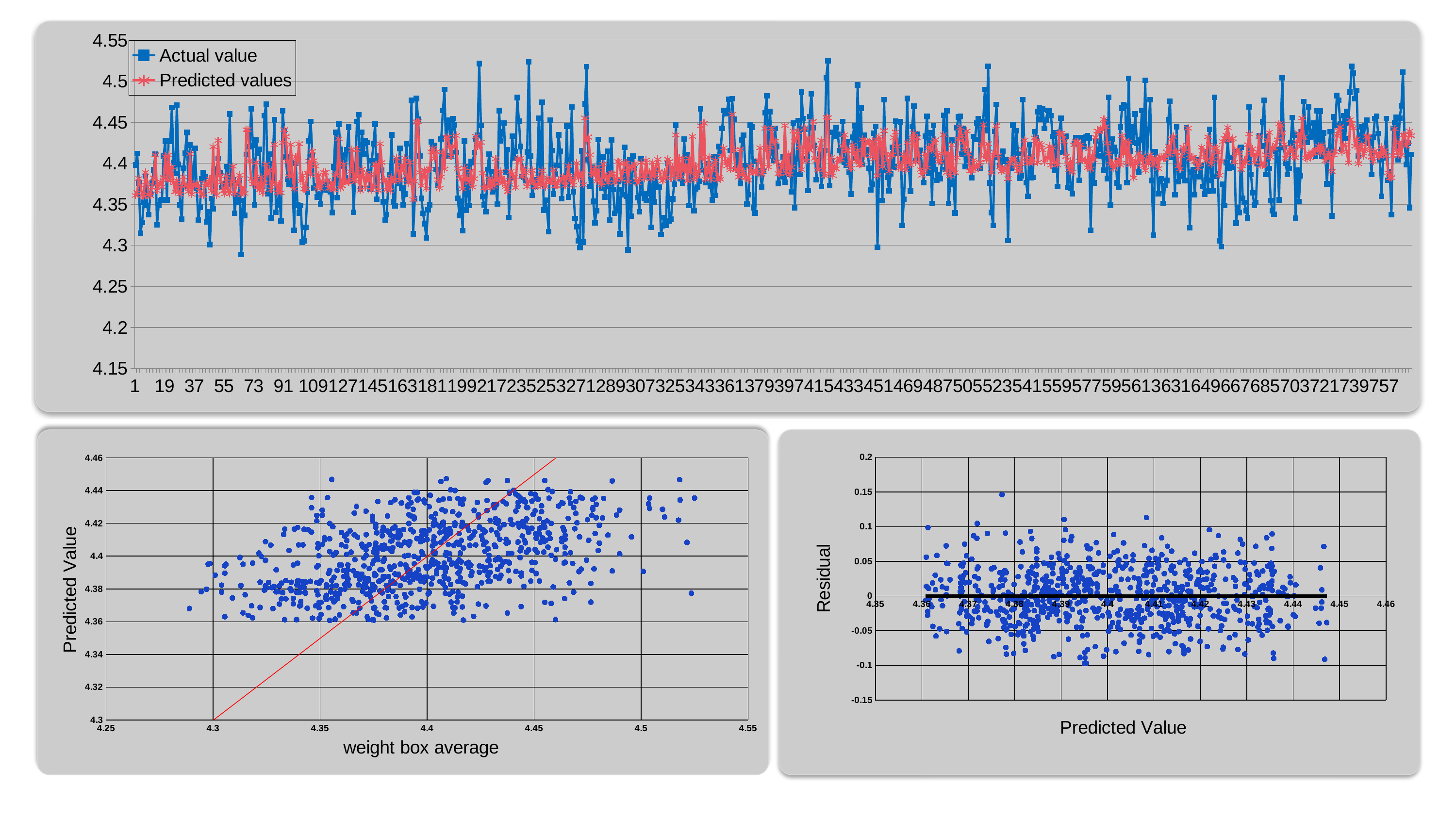
In the top chart, is the first Actual value (at x = 1) greater or less than 4.35? greater In the bottom-left chart, is the highest Predicted Value greater or less than 4.44? greater In the bottom-left chart, does Predicted Value tend to rise or fall as weight box average increases? rise What kind of chart is the bottom-left chart (Predicted Value vs weight box average)? scatter chart How many series does the legend of the top chart list? 2 In the bottom-right chart, is the highest Residual greater or less than 0.1? greater What kind of chart is the top chart on the slide? line chart In the top chart, which series is drawn in blue with square markers? Actual value What kind of chart is the bottom-right chart (Residual vs Predicted Value)? scatter chart What are the two series named in the legend of the top chart? Actual value and Predicted values